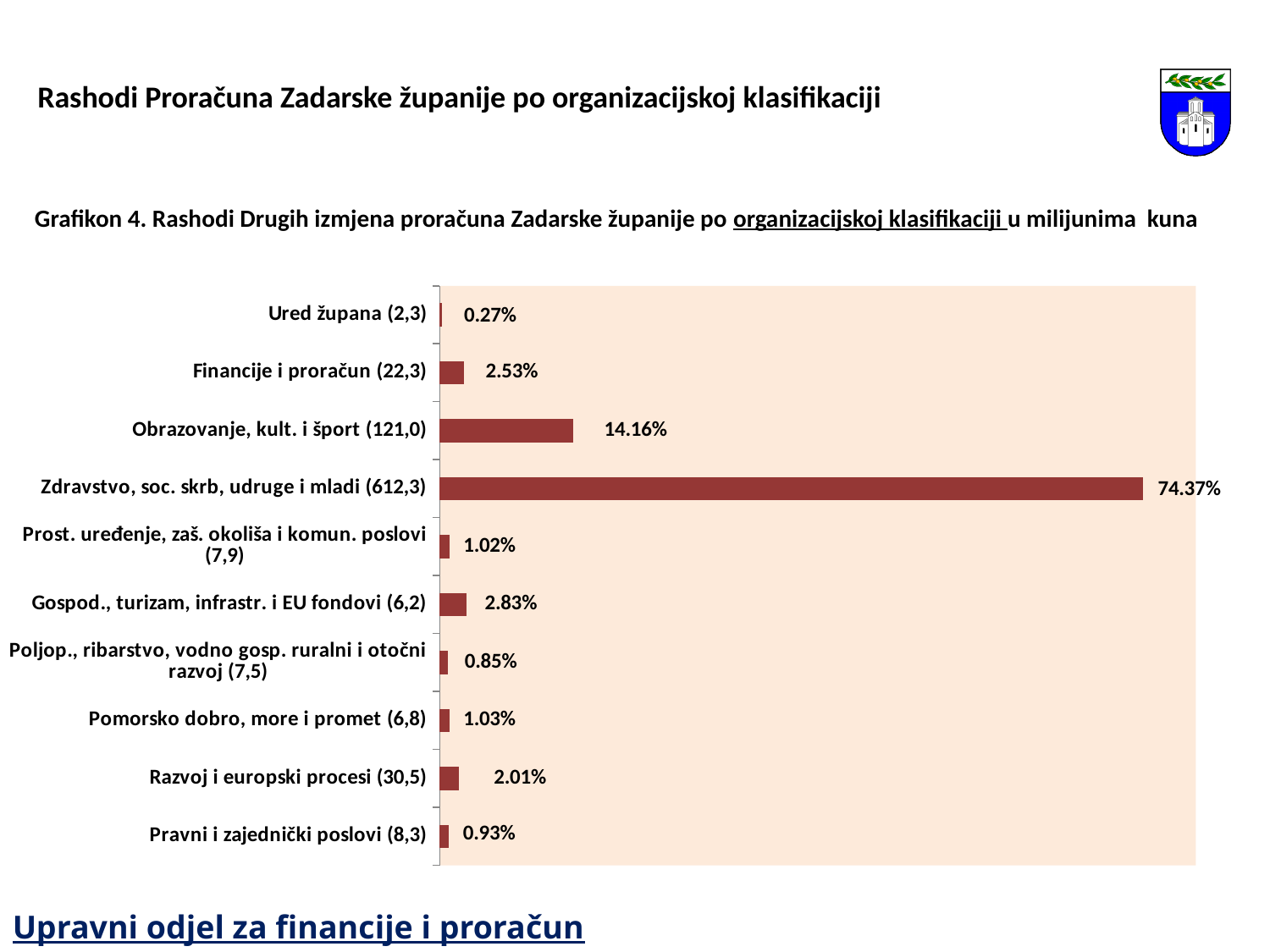
What is the value shown for Zdravstvo, soc. skrb, udruge i mladi (612,3)? 74.37% Which is larger, the value for Financije i proračun (22,3) or the value for Gospod., turizam, infrastr. i EU fondovi (6,2)? Gospod., turizam, infrastr. i EU fondovi (6,2) What is the value shown for Obrazovanje, kult. i šport (121,0)? 14.16% What is the title of the chart (Grafikon 4)? Rashodi Drugih izmjena proračuna Zadarske županije po organizacijskoj klasifikaciji u milijunima kuna Which category has the lowest value? Ured župana (2,3) What kind of chart is shown on the slide? Bar chart What is the value shown for Ured župana (2,3)? 0.27% What is the difference between the values for Financije i proračun (22,3) and Razvoj i europski procesi (30,5)? 0.52% What is the difference between the values for Zdravstvo, soc. skrb, udruge i mladi (612,3) and Obrazovanje, kult. i šport (121,0)? 60.21% What is the value shown for Razvoj i europski procesi (30,5)? 2.01% How many categories are shown in the chart? 10 Which category has the highest value? Zdravstvo, soc. skrb, udruge i mladi (612,3)